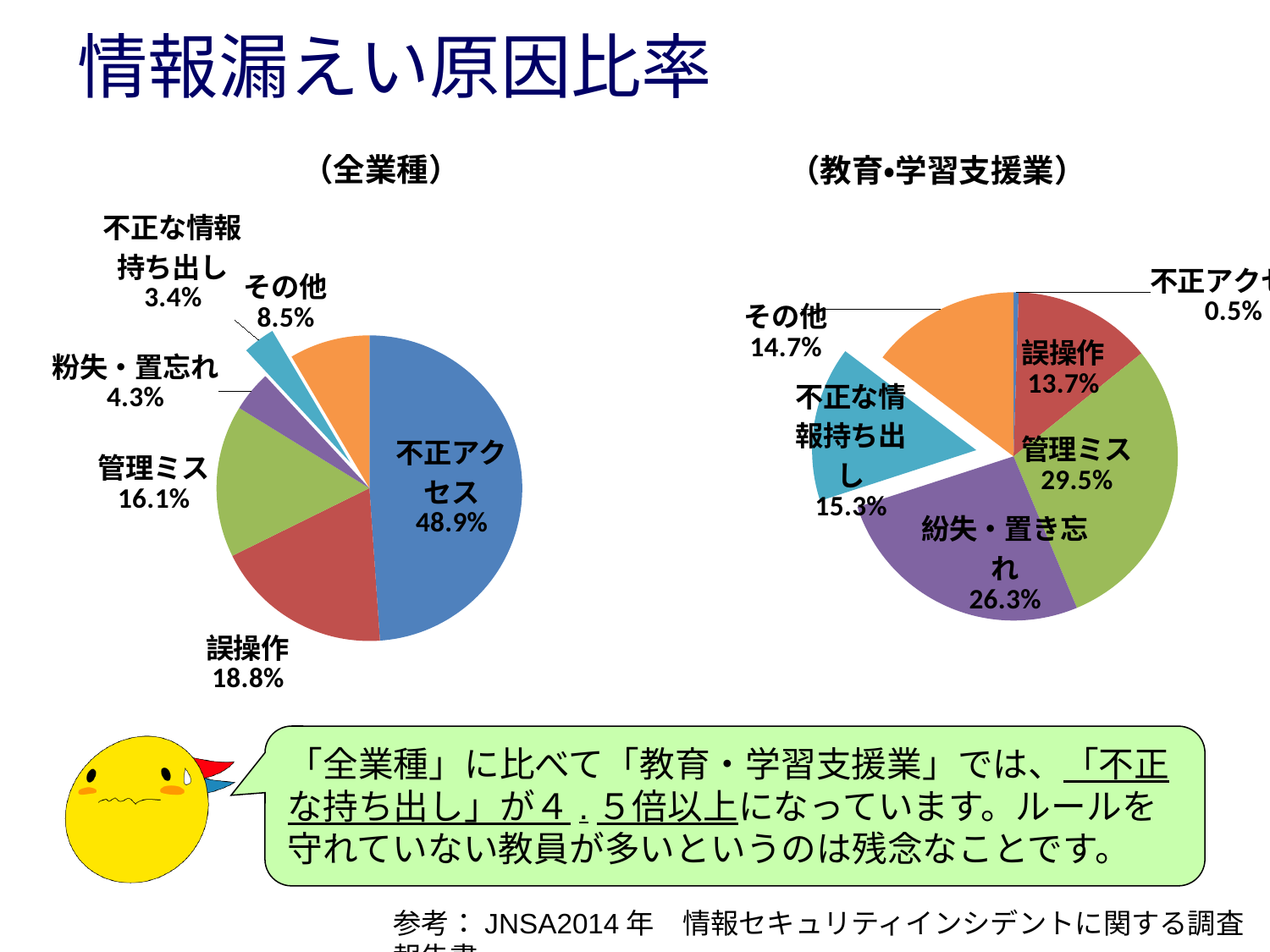
In the (教育・学習支援業) pie chart, what is the share for 紛失・置き忘れ? 26.3% In the (全業種) pie chart, what is the share for 管理ミス? 16.1% What is the difference between the 管理ミス share in the (教育・学習支援業) chart and the 管理ミス share in the (全業種) chart? 13.4% In the (教育・学習支援業) pie chart, which category has the largest share? 管理ミス In the (全業種) pie chart, what is the share for 不正アクセス? 48.9% In the (全業種) pie chart, which category has the smallest share? 不正な情報持ち出し In the (全業種) pie chart, which category has the largest share? 不正アクセス In the (教育・学習支援業) pie chart, what is the share for 不正な情報持ち出し? 15.3% How many slices does the (全業種) pie chart have? 6 What is the title of the chart on the right side of the slide? （教育・学習支援業） In the (教育・学習支援業) pie chart, which is larger, 誤操作 or その他? その他 What type of chart is used on the left side of the slide, titled (全業種)? Pie chart